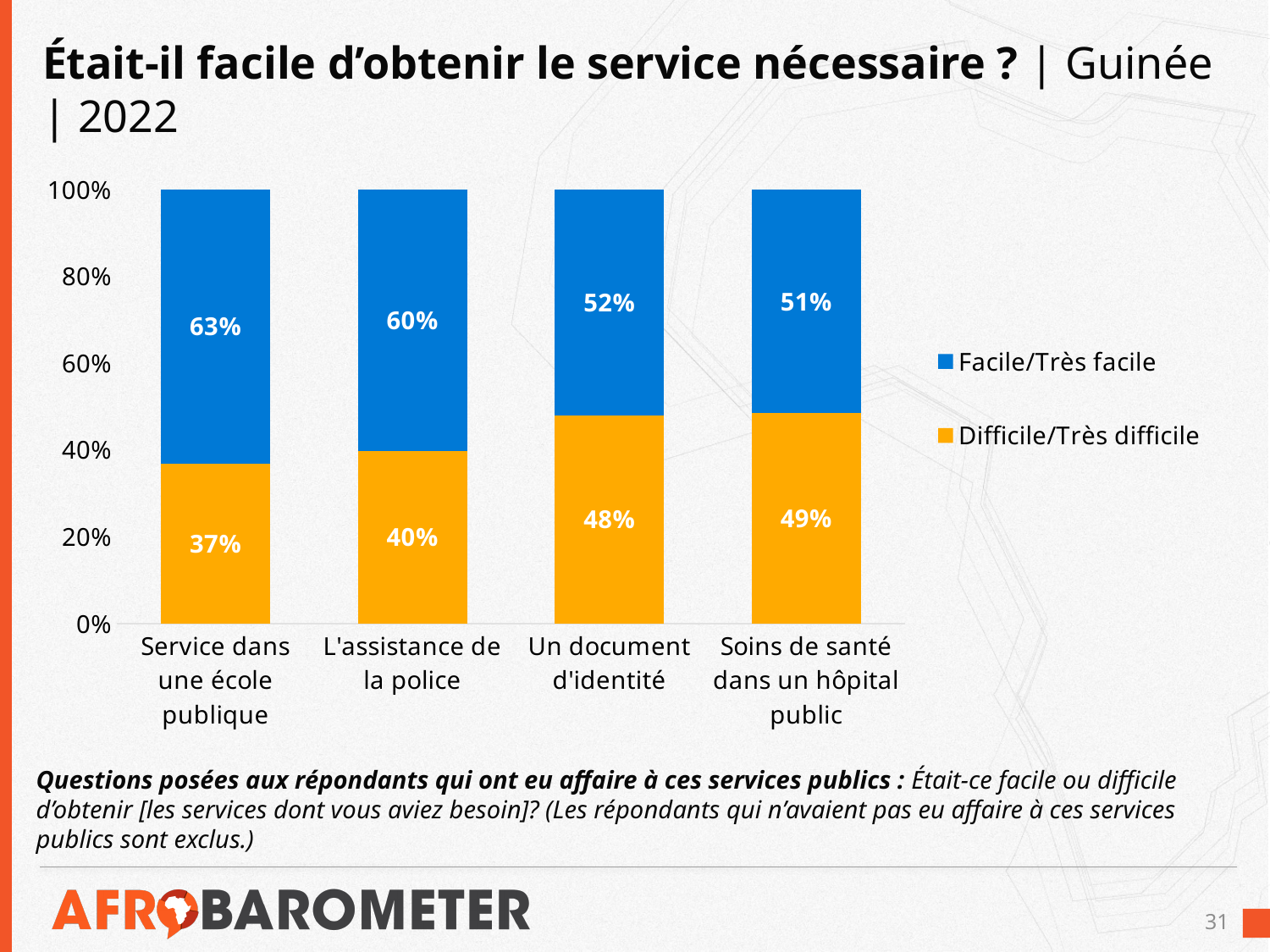
How many service categories are shown on the x axis? 4 Which colour represents Difficile/Très difficile in the chart? Orange What percentage of respondents said it was easy or very easy (Facile/Très facile) to obtain a service in a public school (Service dans une école publique)? 63% Which is larger: the Difficile/Très difficile value for Un document d'identité or for L'assistance de la police? Un document d'identité Do the Facile/Très facile values rise or fall moving from left to right across the categories? Fall What percentage of respondents found it difficult or very difficult (Difficile/Très difficile) to obtain health care in a public hospital (Soins de santé dans un hôpital public)? 49% What is the Difficile/Très difficile value for L'assistance de la police? 40% What is the difference between the Facile/Très facile values for Service dans une école publique and Un document d'identité? 11 percentage points Which service has the lowest Difficile/Très difficile percentage? Service dans une école publique What kind of chart is shown on the slide? Stacked bar chart How many series does the legend list? 2 Which service has the highest Facile/Très facile percentage? Service dans une école publique